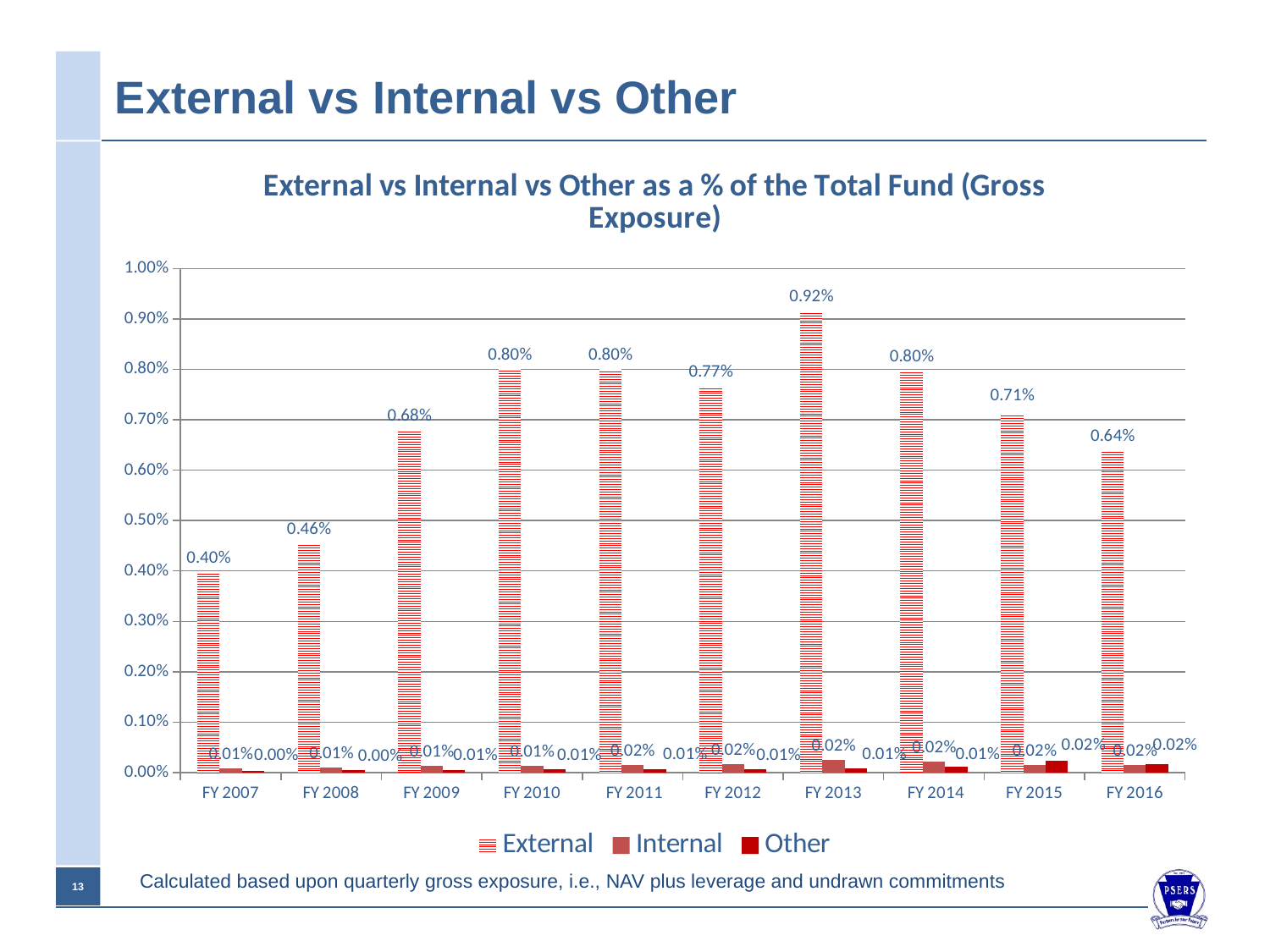
What is the External value for FY 2007? 0.40% Which fiscal year has the lowest External value? FY 2007 What is the External value for FY 2013? 0.92% What kind of chart is shown on the slide? bar chart Which is larger, the External value for FY 2009 or for FY 2015? FY 2015 What is the difference between the External values for FY 2013 and FY 2016? 0.28% Is the External value for FY 2008 greater or less than 0.50%? less How many fiscal years are shown on the x axis? 10 Which fiscal year has the highest External value? FY 2013 What is the title of the chart? External vs Internal vs Other as a % of the Total Fund (Gross Exposure) What is the External value for FY 2016? 0.64% How many series does the legend list? 3